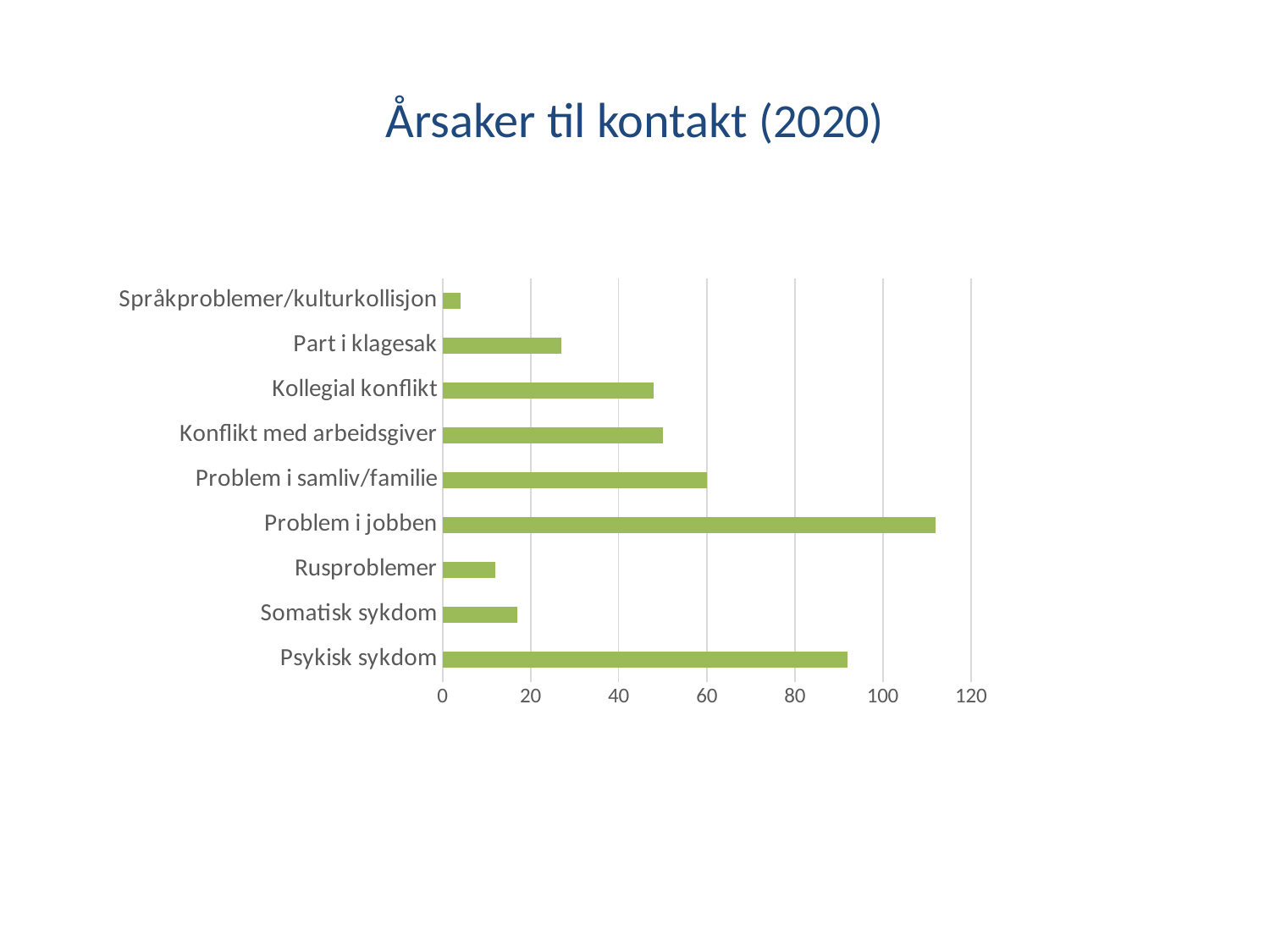
Is the value for Part i klagesak greater or less than 40? less What kind of chart is shown on the slide? Bar chart Is the value for Kollegial konflikt greater or less than 40? greater Which category has the lowest value? Språkproblemer/kulturkollisjon How many categories are shown in the chart? 9 Is the value for Rusproblemer greater or less than 20? less Which is larger, the value for Psykisk sykdom or the value for Problem i samliv/familie? Psykisk sykdom Which category has the highest value? Problem i jobben What is the title of the chart? Årsaker til kontakt (2020)